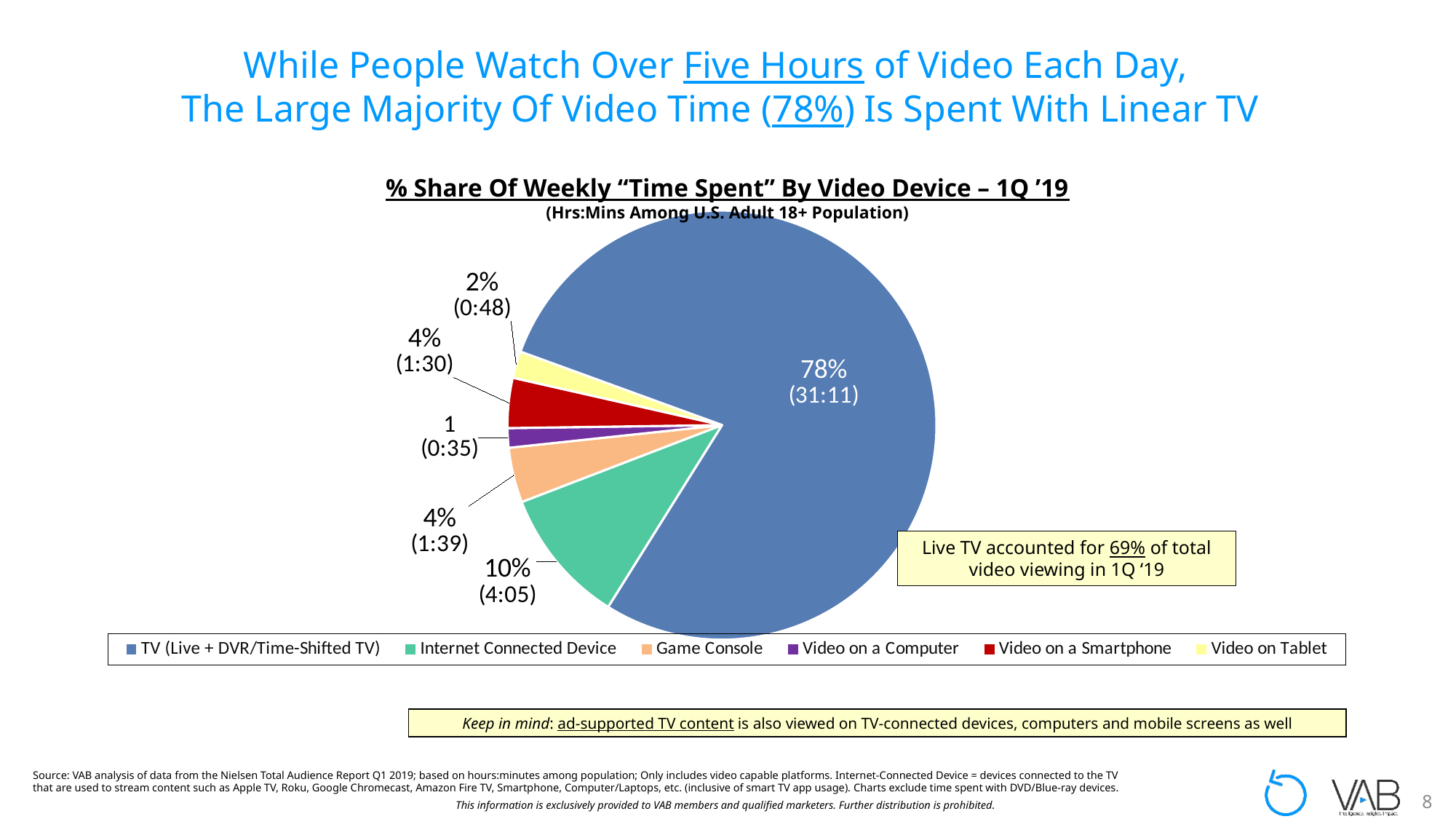
How many hours and minutes per week are spent on Game Console? 1:39 What kind of chart is shown on the slide? pie chart Which device has the largest share of weekly time spent? TV (Live + DVR/Time-Shifted TV) How many hours and minutes per week are spent on Video on a Smartphone? 1:30 How many hours and minutes per week are spent with TV (Live + DVR/Time-Shifted TV)? 31:11 What share of weekly time spent does TV (Live + DVR/Time-Shifted TV) account for? 78% Which device has the smallest share of weekly time spent? Video on a Computer What is the title of the chart? % Share Of Weekly "Time Spent" By Video Device – 1Q '19 How many slices does the pie chart have? 6 Which has a larger share of weekly time spent, Internet Connected Device or Video on Tablet? Internet Connected Device What share of weekly time spent does Video on Tablet account for? 2% What share of weekly time spent does Internet Connected Device account for? 10%